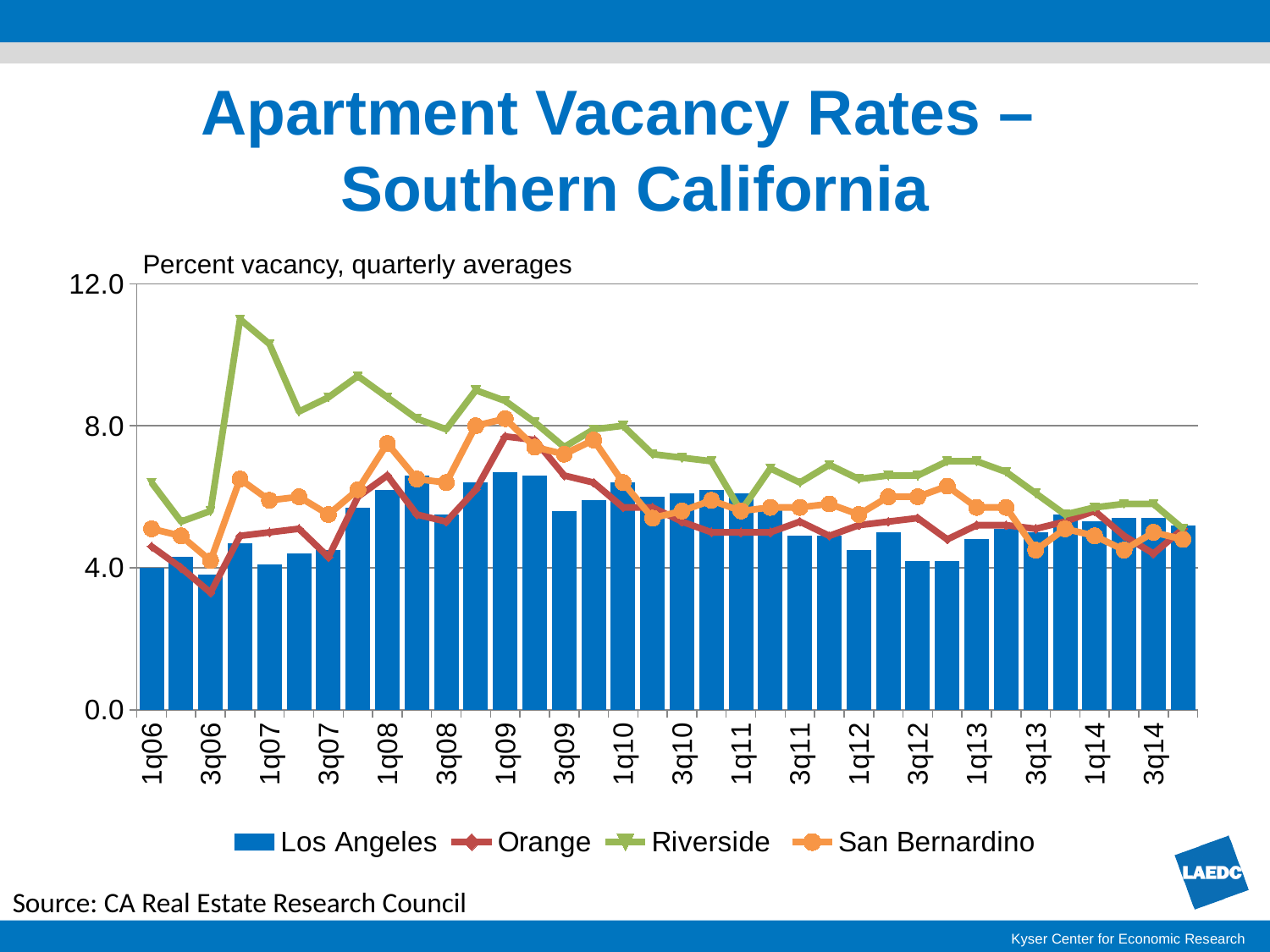
Which series has the highest value at 1q07? Riverside Is the Los Angeles value at 1q09 greater or less than 8.0? less What is the chart's title? Apartment Vacancy Rates – Southern California What kind of chart is shown on the slide? A combination bar and line chart How many series does the legend list? 4 Does the Riverside line generally rise or fall from 1q07 to 3q14? fall Which series is plotted as bars rather than a line? Los Angeles Is the Riverside value at 3q06 greater or less than 8.0? less Which is larger, the Riverside value or the Orange value at 1q07? Riverside Which series reaches the highest value anywhere on the chart? Riverside Is the Orange value at 3q06 greater or less than 4.0? less